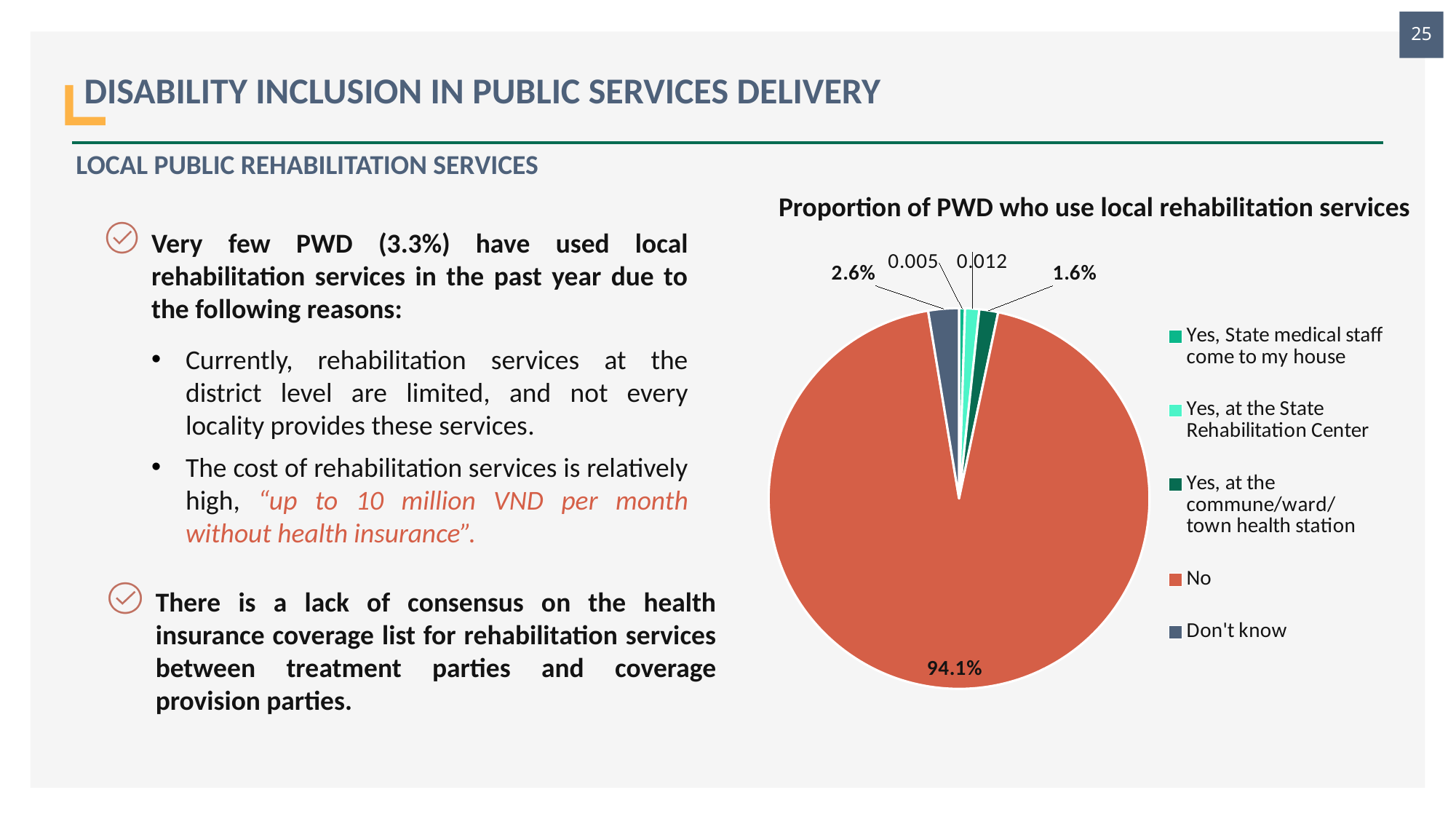
What is the value shown for "Yes, at the commune/ward/town health station"? 1.6% How many categories does the pie chart's legend list? 5 What is the value shown for "Don't know"? 2.6% What is the value shown for "Yes, at the State Rehabilitation Center"? 0.012 Which category has the largest slice of the pie? No Which is larger, the slice for "Don't know" or the slice for "Yes, at the commune/ward/town health station"? Don't know What kind of chart is shown on the slide? Pie chart What is the value shown for "Yes, State medical staff come to my house"? 0.005 What is the difference between the "No" share and the "Don't know" share? 91.5% What is the title of the chart? Proportion of PWD who use local rehabilitation services Which category has the smallest slice of the pie? Yes, State medical staff come to my house What share of the pie is labelled "No"? 94.1%